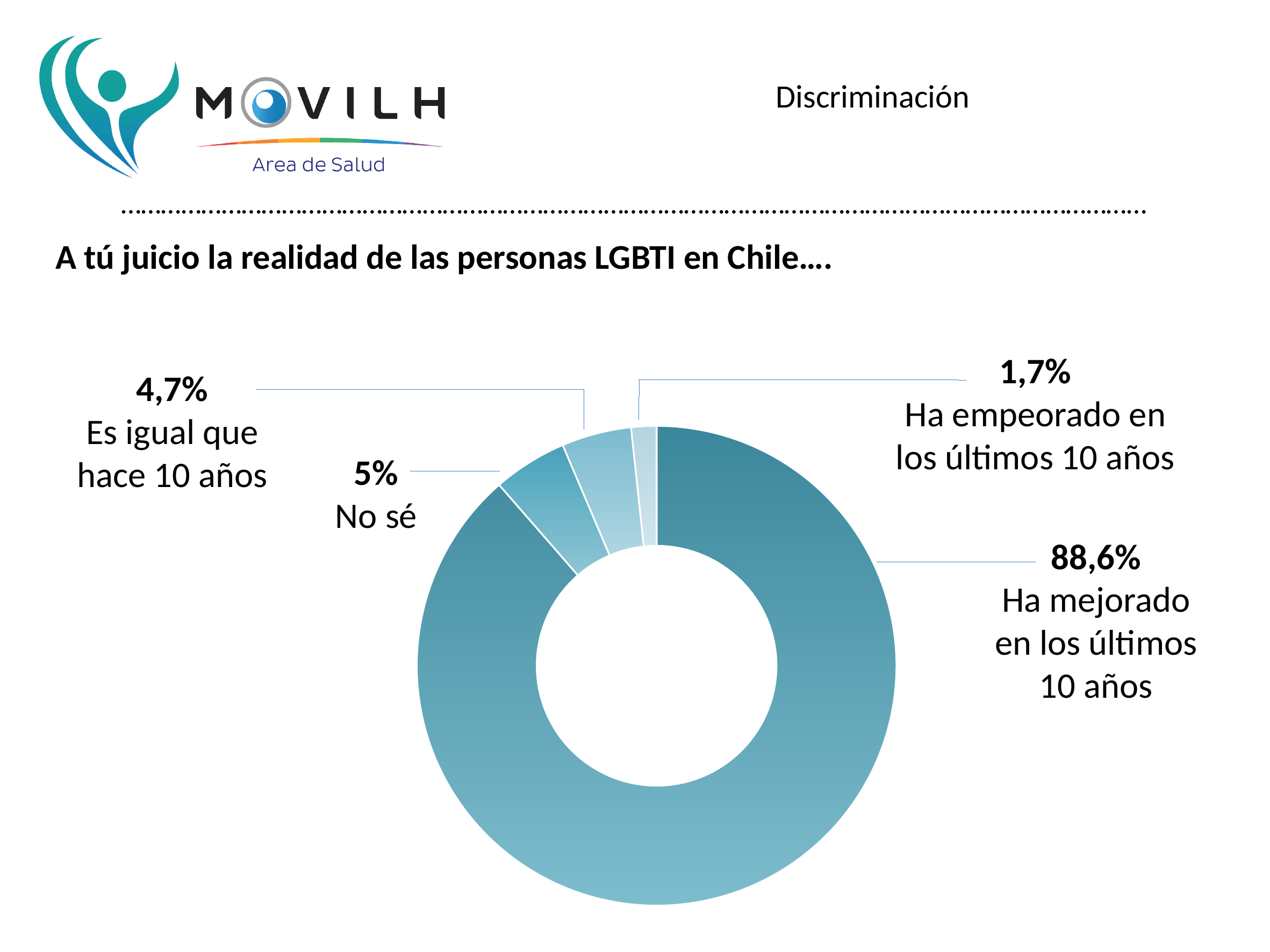
Which is larger: the share for 'No sé' or the share for 'Es igual que hace 10 años'? No sé What percentage of respondents said the reality of LGBTI people in Chile 'Ha mejorado en los últimos 10 años'? 88,6% What percentage of respondents said it 'Ha empeorado en los últimos 10 años'? 1,7% What is the difference in percentage points between 'Ha mejorado en los últimos 10 años' and 'Ha empeorado en los últimos 10 años'? 86,9 Which response has the largest share of the chart? Ha mejorado en los últimos 10 años Which response has the smallest share of the chart? Ha empeorado en los últimos 10 años What percentage of respondents answered 'No sé'? 5% What is the combined share of 'No sé' and 'Es igual que hace 10 años'? 9,7% What question does the chart on the slide answer? A tú juicio la realidad de las personas LGBTI en Chile…. What kind of chart is shown on the slide? Doughnut (pie) chart What percentage of respondents said it 'Es igual que hace 10 años'? 4,7% How many response categories are shown in the chart? 4